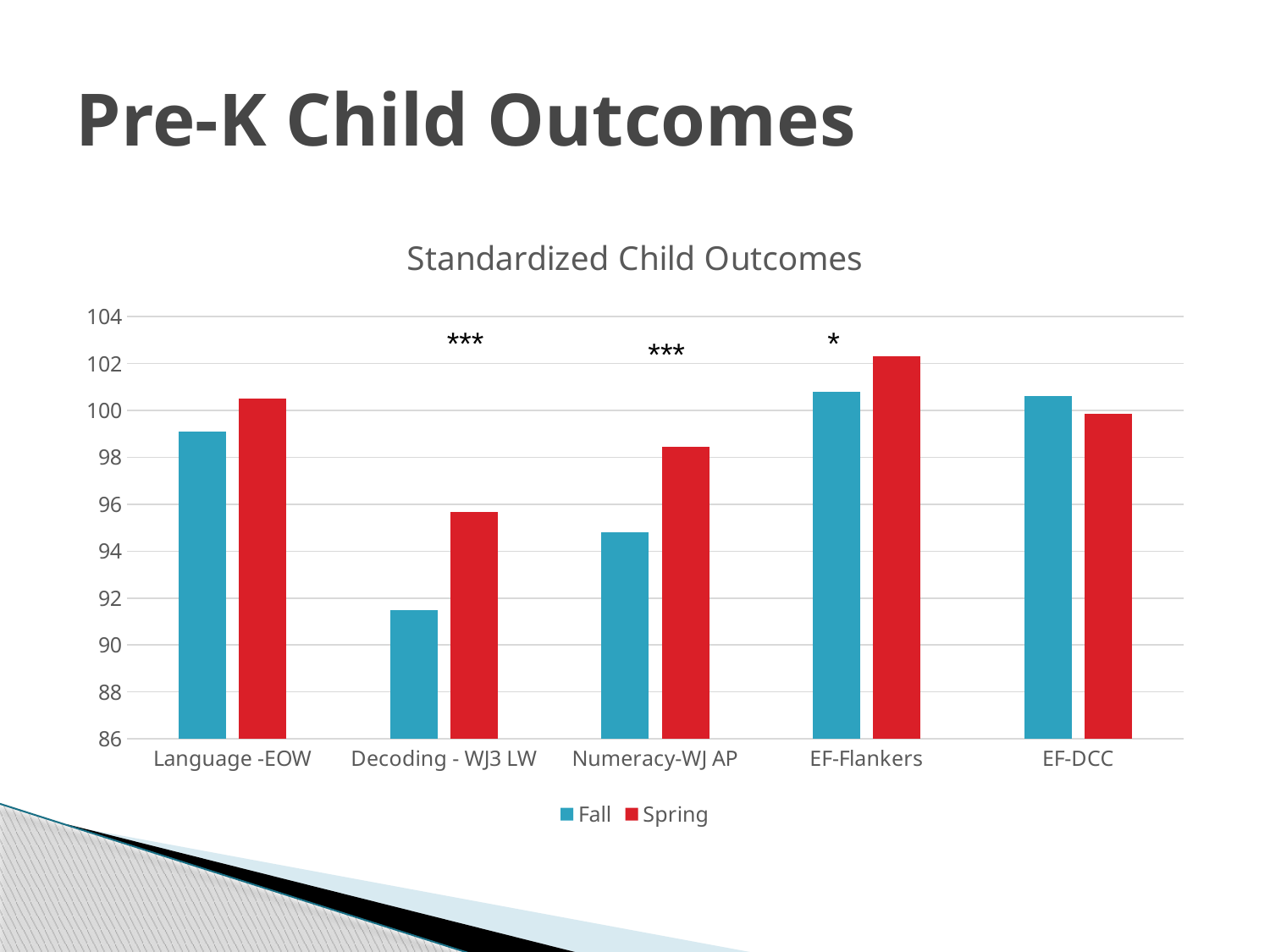
How many outcome categories are shown on the x axis? 5 What is the title of the chart? Standardized Child Outcomes Which category has the highest Spring value? EF-Flankers What kind of chart is shown on the slide? bar chart Which category has the lowest Fall value? Decoding - WJ3 LW Is the Fall value for Decoding - WJ3 LW greater or less than 92? less Which category has the lowest Spring value? Decoding - WJ3 LW For Decoding - WJ3 LW, which is larger, the Fall value or the Spring value? Spring Is the Spring value for EF-Flankers greater or less than 102? greater Is the Fall value for Numeracy-WJ AP greater or less than 96? less How many series does the legend list? 2 For EF-DCC, which is larger, the Fall value or the Spring value? Fall